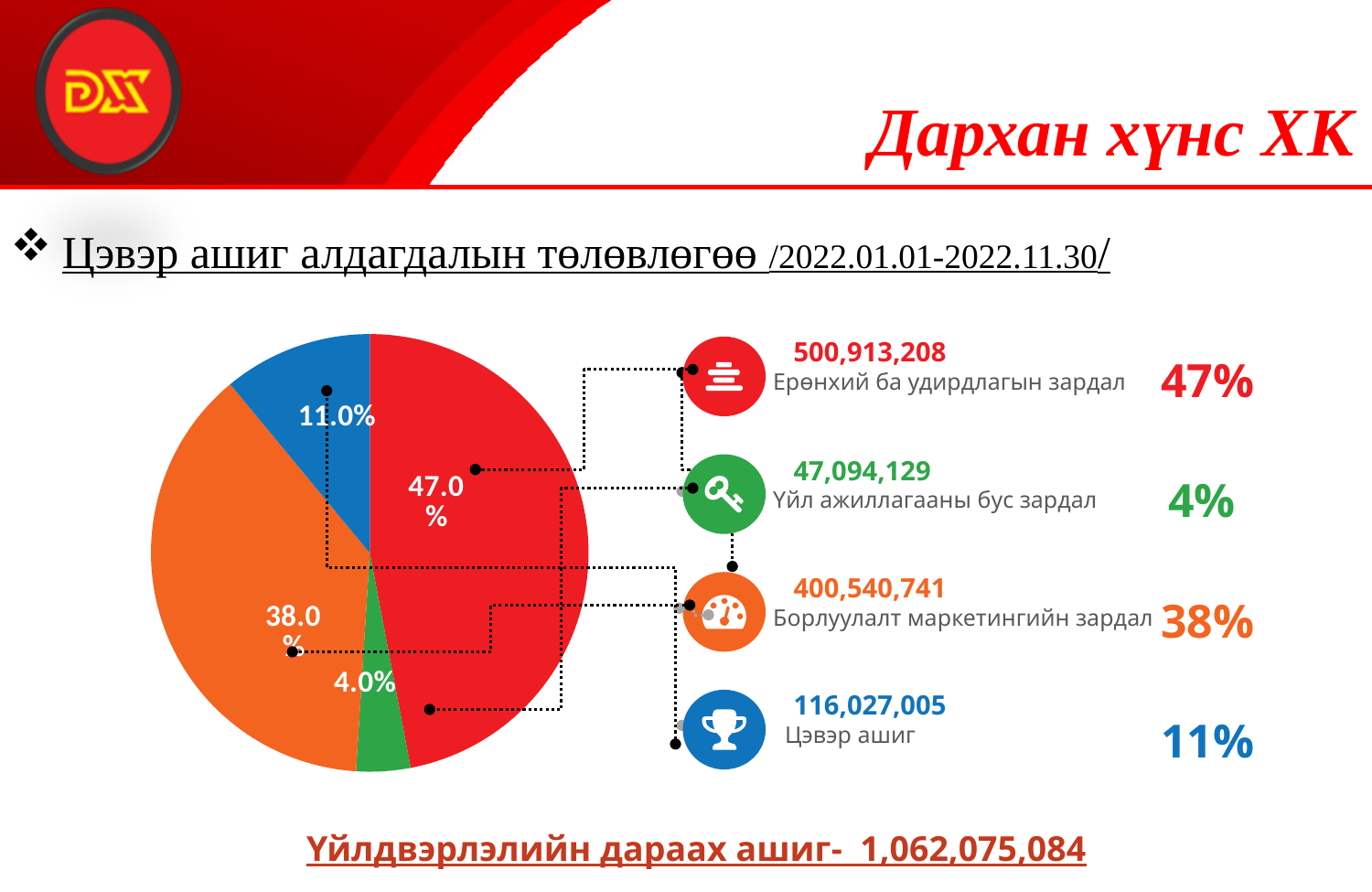
What share of the pie does Цэвэр ашиг represent? 11.0% Which is larger, the amount for Борлуулалт маркетингийн зардал or the amount for Цэвэр ашиг? Борлуулалт маркетингийн зардал How many slices does the pie chart have? 4 Which category has the smallest slice of the pie? Үйл ажиллагааны бус зардал What share of the pie does Ерөнхий ба удирдлагын зардал represent? 47.0% What is the amount shown for Цэвэр ашиг? 116,027,005 What is the difference in percentage points between the Ерөнхий ба удирдлагын зардал slice and the Борлуулалт маркетингийн зардал slice? 9.0 percentage points What is the amount shown for Үйл ажиллагааны бус зардал? 47,094,129 What is the amount shown for Борлуулалт маркетингийн зардал? 400,540,741 What colour is the slice for Цэвэр ашиг? blue Which category has the largest slice of the pie? Ерөнхий ба удирдлагын зардал What type of chart is shown on the slide? pie chart